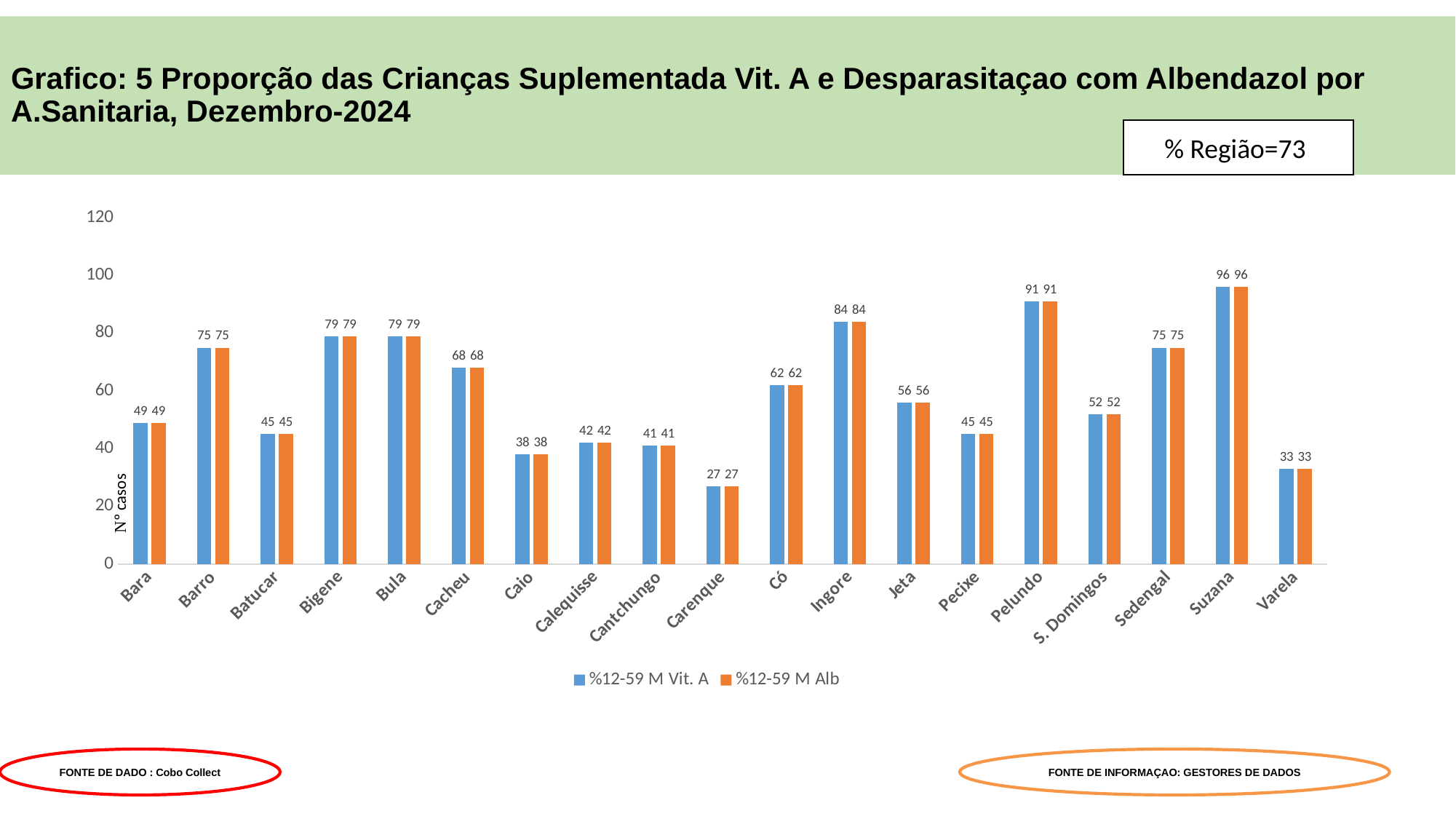
Which category has the lowest value for %12-59 M Alb? Carenque What kind of chart is shown on the slide? bar chart What is the value of %12-59 M Alb for Ingore? 84 How many series does the legend list? 2 What is the value of %12-59 M Vit. A for Carenque? 27 Is the value of %12-59 M Vit. A for Bigene greater or less than 60? greater Which category has the highest value for %12-59 M Vit. A? Suzana What is the difference between the %12-59 M Vit. A values for Pelundo and Varela? 58 How many categories are shown on the x axis? 19 Which is larger, the %12-59 M Alb value for Jeta or for Có? Có What is the regional percentage shown in the box at the top right of the slide? % Região=73 What is the value of %12-59 M Vit. A for Cacheu? 68